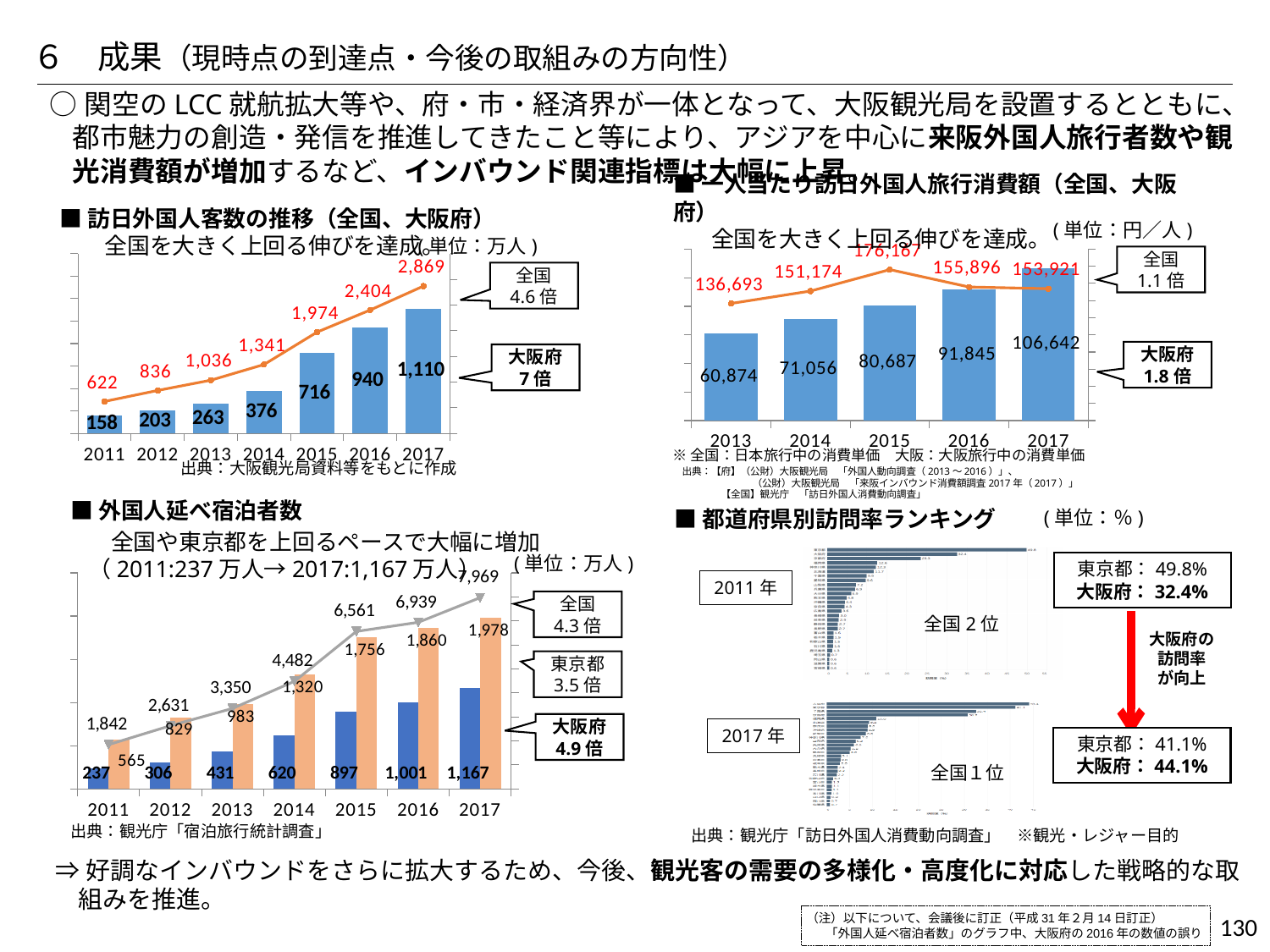
「外国人延べ宿泊者数」のグラフで、2017年の全国の値はいくつですか？ 7,969 「訪日外国人客数の推移（全国、大阪府）」のグラフで、2015年の全国の値はいくつですか？ 1,974 「一人当たり訪日外国人旅行消費額（全国、大阪府）」のグラフで、大阪府の値が最も低い年はどれですか？ 2013 「訪日外国人客数の推移（全国、大阪府）」のグラフで、2017年の全国と大阪府の差はいくつですか？ 1,759 「一人当たり訪日外国人旅行消費額（全国、大阪府）」のグラフで、2017年の大阪府の値はいくつですか？ 106,642 「外国人延べ宿泊者数」のグラフで、2014年の東京都の値はいくつですか？ 1,320 「一人当たり訪日外国人旅行消費額（全国、大阪府）」のグラフには何年分のデータがありますか？ 5 「外国人延べ宿泊者数」のグラフはどの種類のグラフですか？ 棒グラフと折れ線グラフの組み合わせ 「一人当たり訪日外国人旅行消費額（全国、大阪府）」のグラフで、全国の値が最も高い年はどれですか？ 2015 「訪日外国人客数の推移（全国、大阪府）」のグラフで、2017年の大阪府の値はいくつですか？ 1,110 「外国人延べ宿泊者数」のグラフで、2016年の東京都と大阪府ではどちらの値が大きいですか？ 東京都 「訪日外国人客数の推移（全国、大阪府）」のグラフで、2011年から2017年にかけて大阪府の値は増加していますか、減少していますか？ 増加